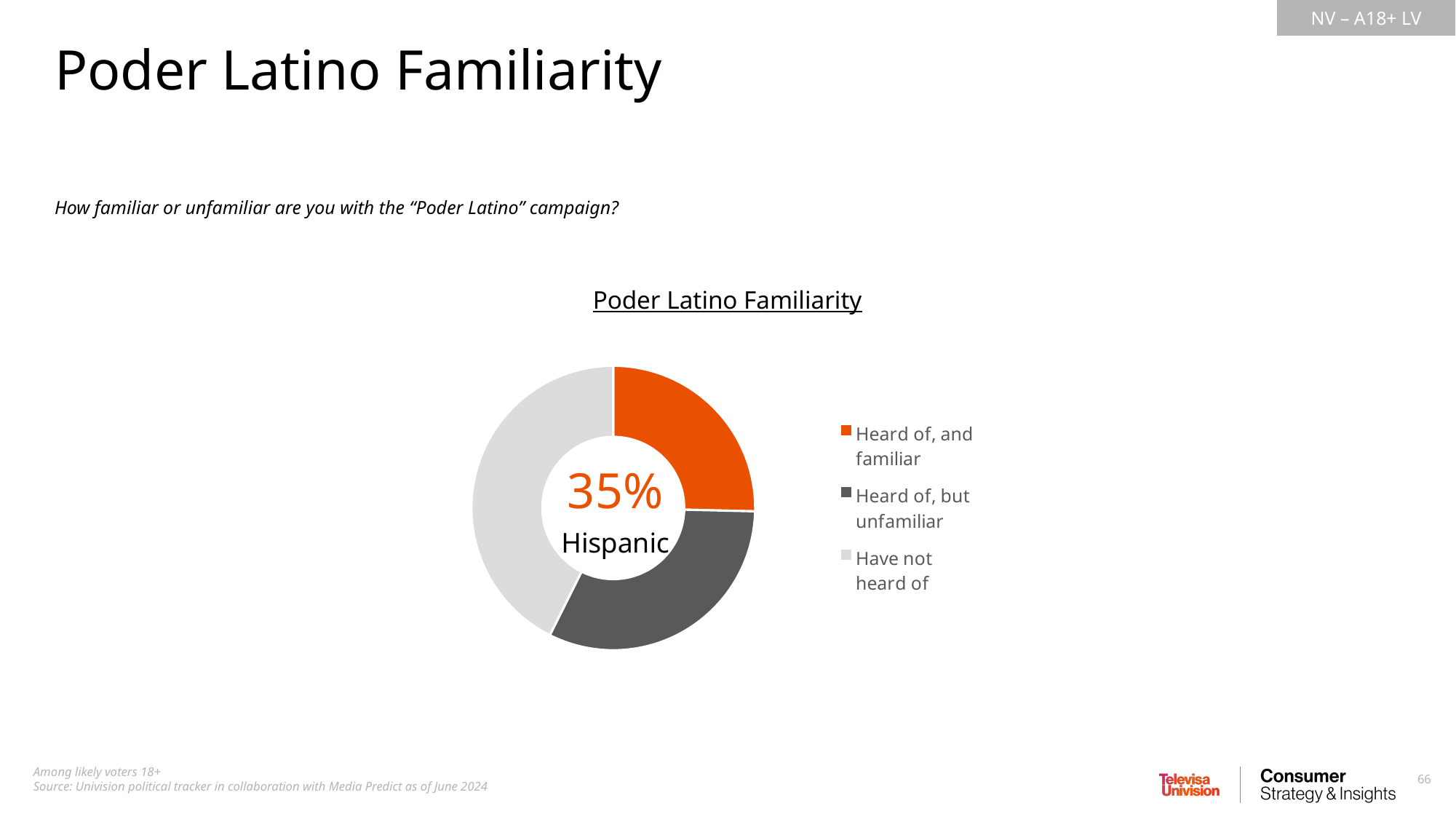
Which category has the largest slice in the Poder Latino Familiarity chart? Have not heard of Which slice is larger: 'Have not heard of' or 'Heard of, but unfamiliar'? Have not heard of What percentage is printed in the center of the donut chart? 35% What kind of chart is shown on the slide? Pie chart (donut) Which slice is larger: 'Have not heard of' or 'Heard of, and familiar'? Have not heard of Which category has the smallest slice in the Poder Latino Familiarity chart? Heard of, and familiar How many entries does the legend of the Poder Latino Familiarity chart list? 3 How many slices does the Poder Latino Familiarity chart have? 3 Which legend category is shown in orange? Heard of, and familiar What is the title of the chart on the slide? Poder Latino Familiarity